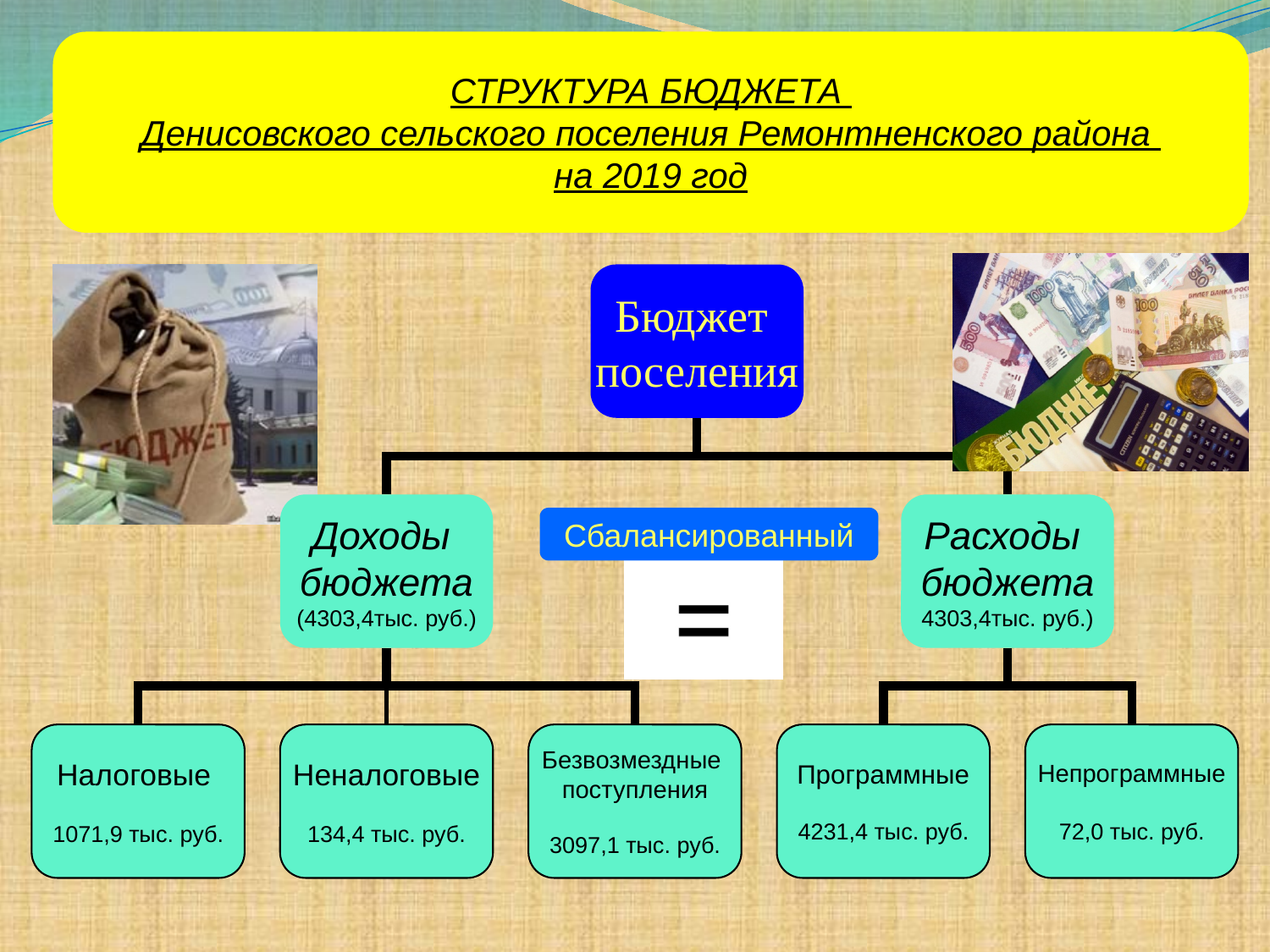
What total is shown for Доходы бюджета (budget revenues)? 4303,4 тыс. руб. Which of the three revenue categories has the largest value? Безвозмездные поступления What is the difference between Программные and Непрограммные expenditures? 4159,4 тыс. руб. What kind of chart is shown on the slide? Hierarchy (tree) diagram Which is larger, Налоговые or Неналоговые revenues? Налоговые How many revenue categories are shown under Доходы бюджета? 3 What is the value shown for Налоговые (tax revenues) in the diagram? 1071,9 тыс. руб. What is the value shown for Неналоговые (non-tax revenues)? 134,4 тыс. руб. What is the value shown for Программные expenditures? 4231,4 тыс. руб. What is the value shown for Безвозмездные поступления? 3097,1 тыс. руб. What is the value shown for Непрограммные expenditures? 72,0 тыс. руб. Which of the three revenue categories has the smallest value? Неналоговые